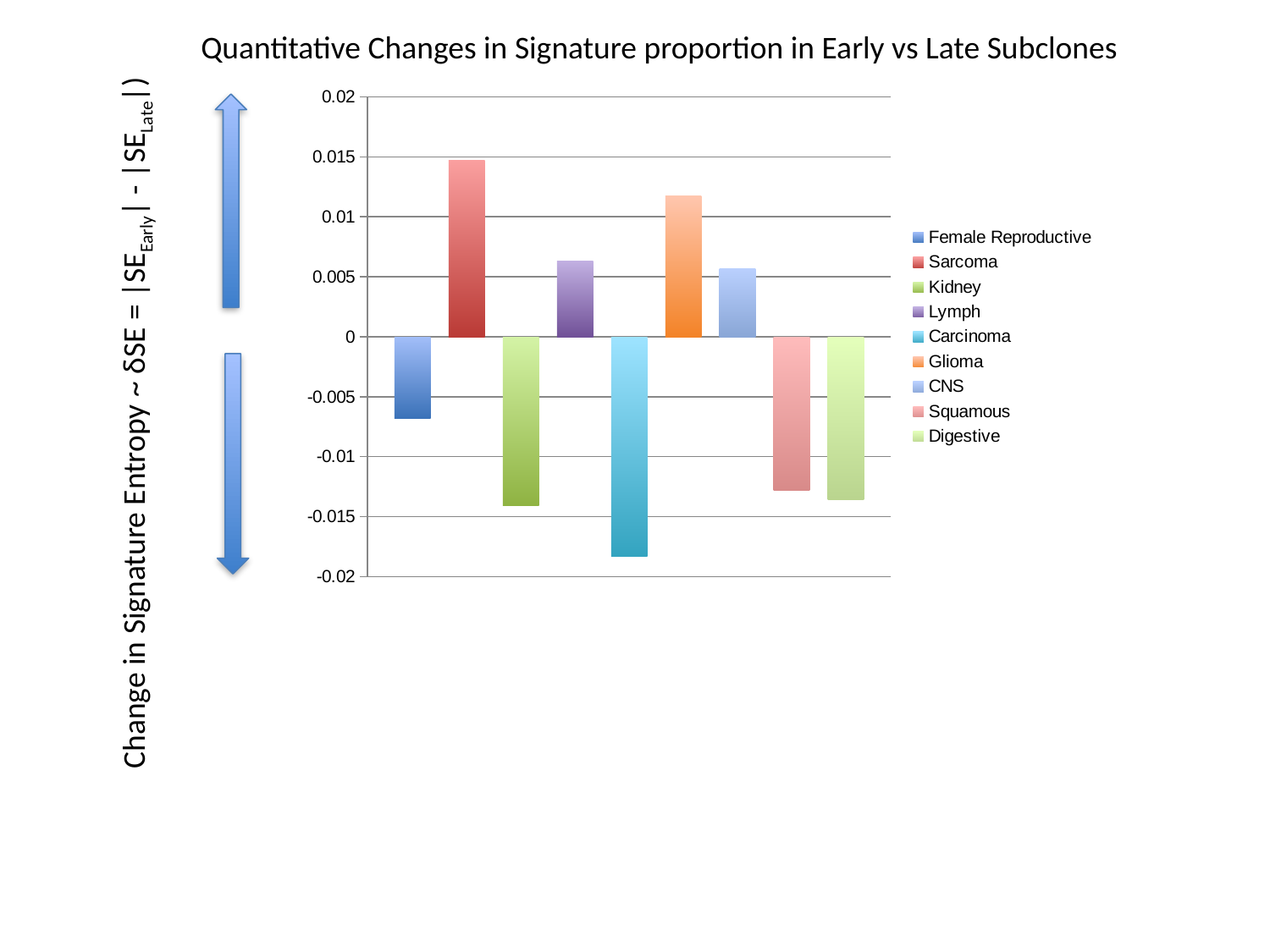
Which is larger, the value for Female Reproductive or the value for Squamous? Female Reproductive Which category has the lowest value? Carcinoma What is the title of the chart? Quantitative Changes in Signature proportion in Early vs Late Subclones Which is larger, the value for Sarcoma or the value for Glioma? Sarcoma Is the value for Carcinoma greater or less than -0.015? less Is the value for Sarcoma greater or less than 0.01? greater How many bars are plotted in the chart? 9 Is the value for Kidney greater or less than -0.01? less Which category has the highest value? Sarcoma What kind of chart is shown on the slide? bar chart How many series does the legend list? 9